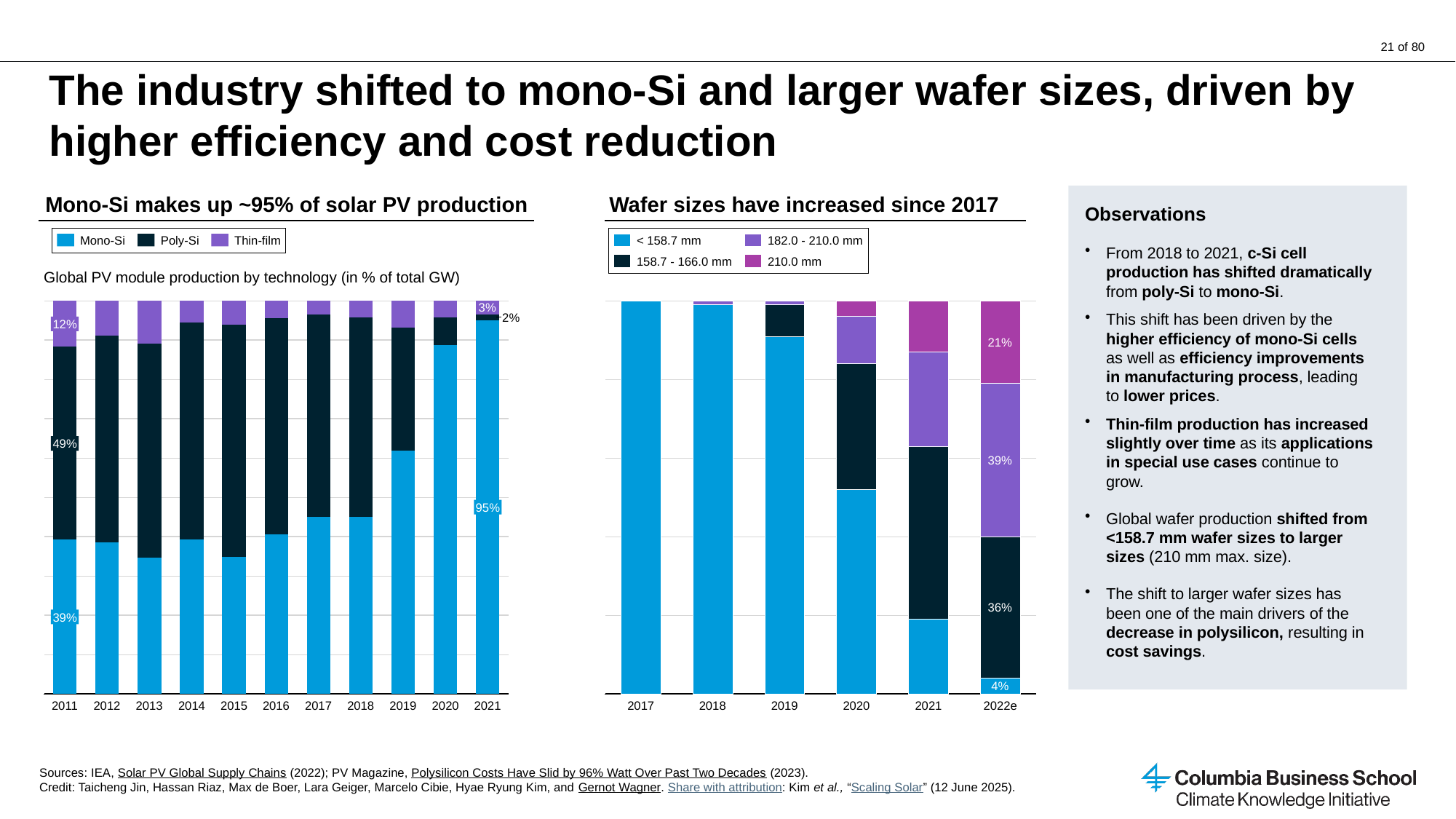
In the chart titled "Mono-Si makes up ~95% of solar PV production", how many series does the legend list? 3 In the chart titled "Mono-Si makes up ~95% of solar PV production", what share did Mono-Si have in 2021? 95% In the chart titled "Wafer sizes have increased since 2017", what share did the 210.0 mm wafer size have in 2022e? 21% In the chart titled "Mono-Si makes up ~95% of solar PV production", what share did Poly-Si have in 2011? 49% In the chart titled "Mono-Si makes up ~95% of solar PV production", does the Mono-Si share rise or fall from 2011 to 2021? rise In the chart titled "Mono-Si makes up ~95% of solar PV production", how many years are shown on the x axis? 11 In the chart titled "Mono-Si makes up ~95% of solar PV production", what share did Mono-Si have in 2011? 39% In the chart titled "Mono-Si makes up ~95% of solar PV production", what share did Thin-film have in 2021? 3% In the chart titled "Wafer sizes have increased since 2017", how many series does the legend list? 4 What kind of chart is the one titled "Wafer sizes have increased since 2017"? stacked bar chart In the chart titled "Wafer sizes have increased since 2017", what share did the 182.0 - 210.0 mm wafer size have in 2022e? 39% In the chart titled "Mono-Si makes up ~95% of solar PV production", how many percentage points higher was Poly-Si than Mono-Si in 2011? 10